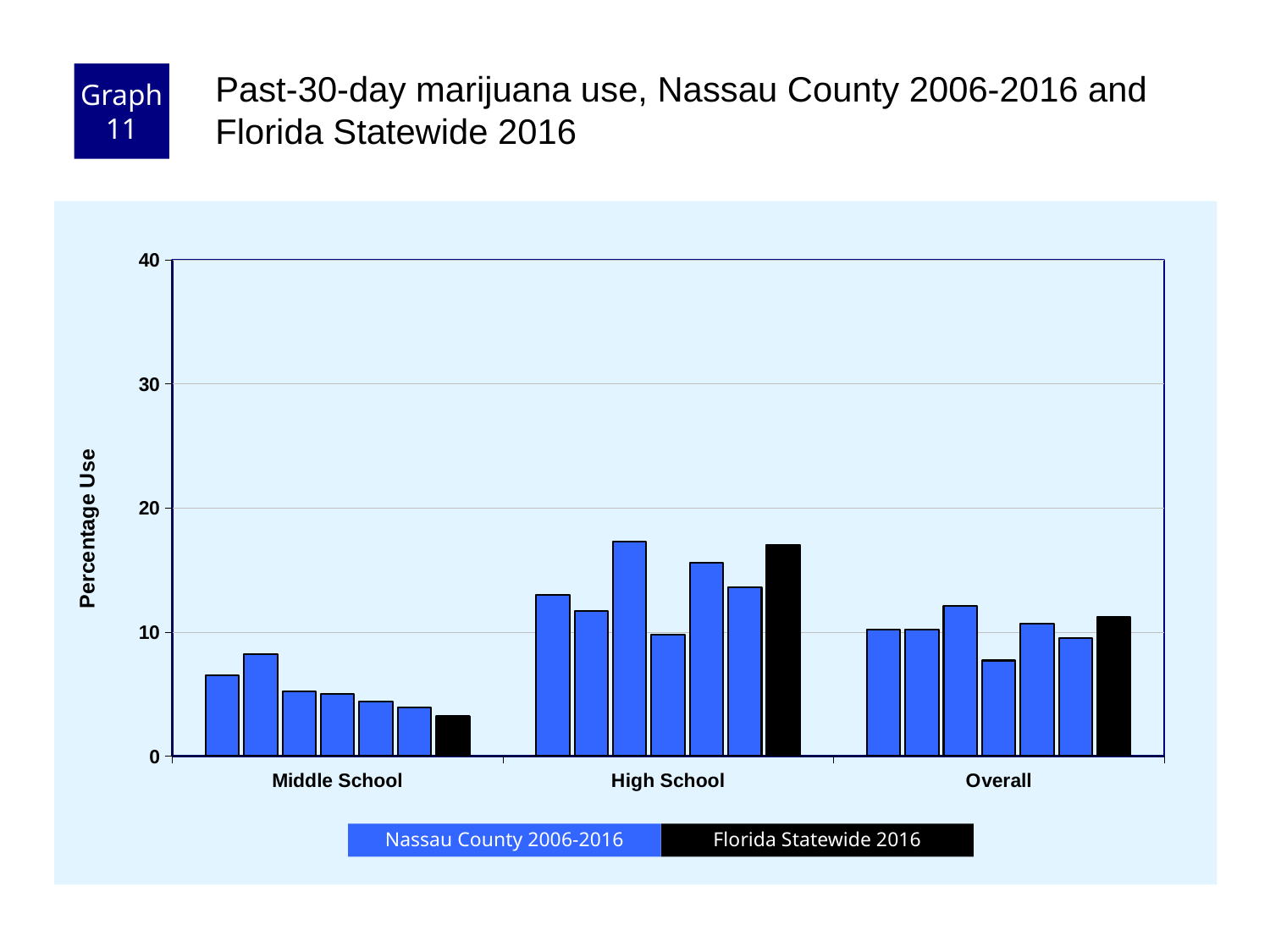
What kind of chart is shown on the slide? bar chart Which series is shown in black? Florida Statewide 2016 What is the label of the y axis? Percentage Use Which category has the highest Florida Statewide 2016 value? High School Is the Florida Statewide 2016 value for High School greater or less than 10? greater Which category has the lowest Florida Statewide 2016 value? Middle School Is the Florida Statewide 2016 value for High School greater or less than 20? less How many categories are shown on the x axis? 3 How many series does the legend list? 2 Is the Florida Statewide 2016 value for Middle School greater or less than 10? less Which is larger, the Florida Statewide 2016 value for High School or for Middle School? High School